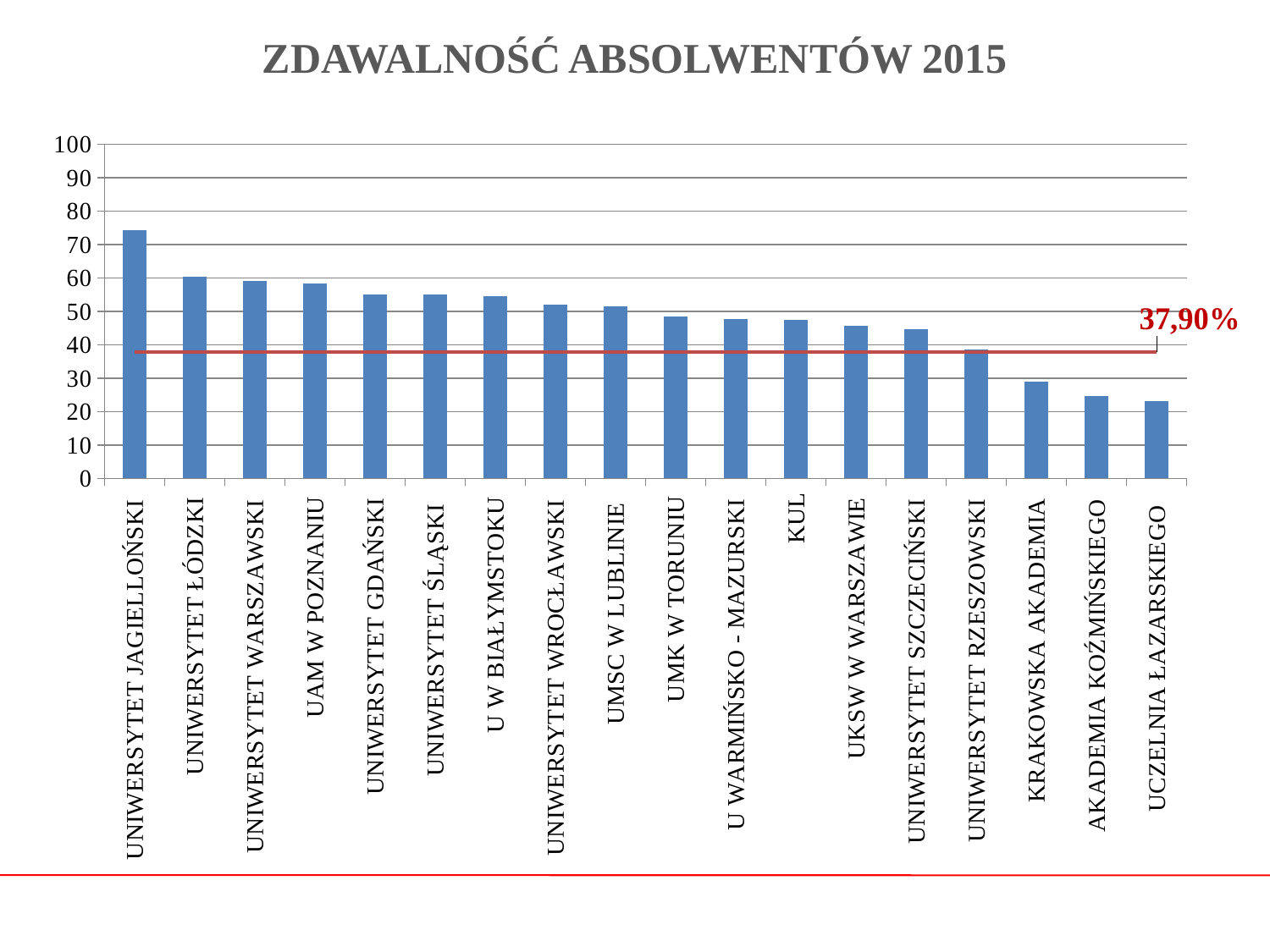
Which university has the lowest value? UCZELNIA ŁAZARSKIEGO Is the value for UNIWERSYTET JAGIELLOŃSKI greater or less than 70? greater Which is larger, the value for UNIWERSYTET WARSZAWSKI or the value for KUL? UNIWERSYTET WARSZAWSKI What is the title of the chart? ZDAWALNOŚĆ ABSOLWENTÓW 2015 What value is labelled on the red horizontal line? 37,90% Do the values generally rise or fall from left to right along the x axis? fall How many universities (categories) are shown on the x axis? 18 Which university has the highest value? UNIWERSYTET JAGIELLOŃSKI Is the value for AKADEMIA KOŹMIŃSKIEGO greater or less than 30? less What kind of chart is shown on the slide? bar chart